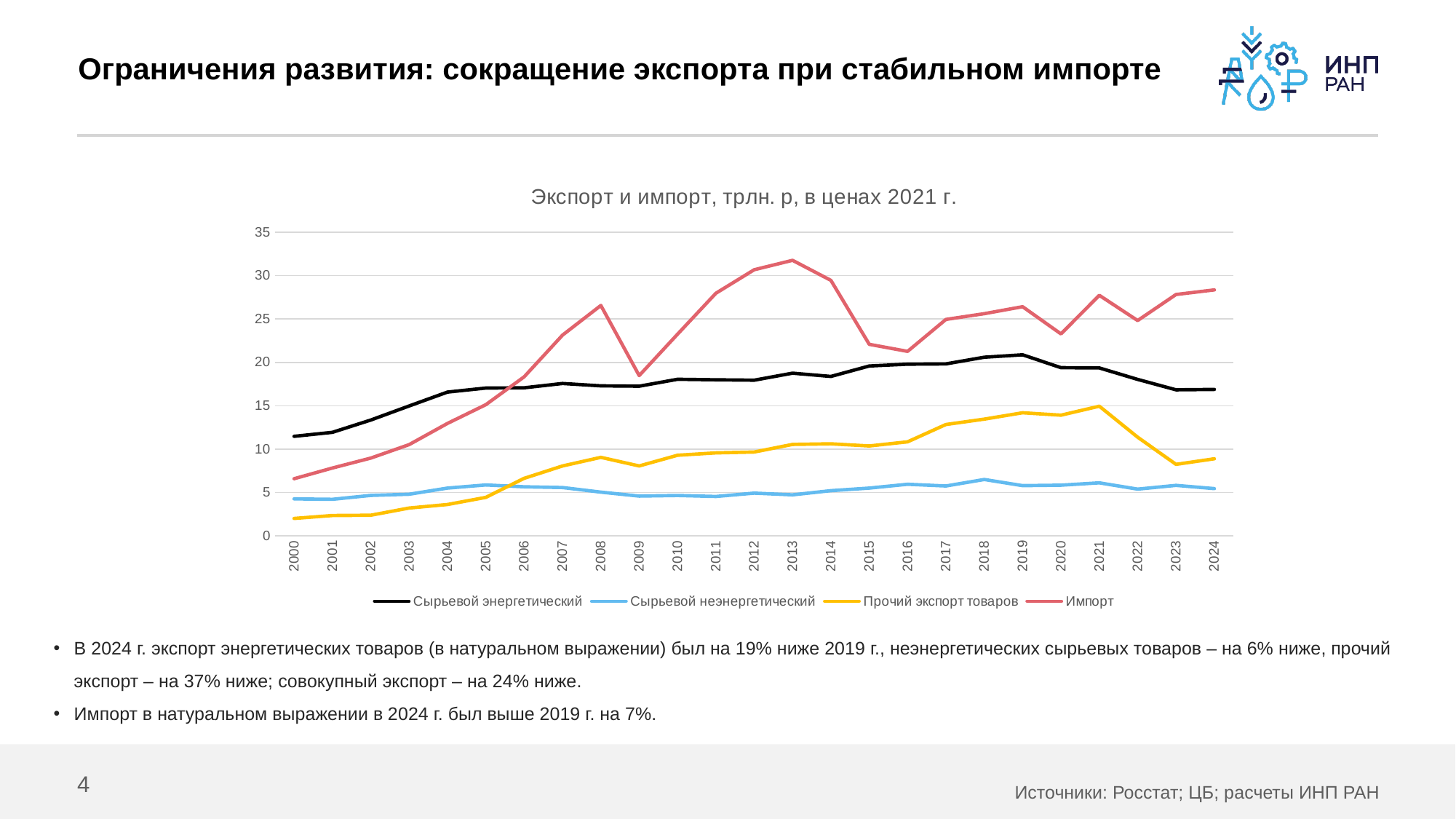
In which year does Импорт reach its highest value? 2013 Which series has the lowest value in 2000? Прочий экспорт товаров Is the value for Импорт in 2000 greater or less than 10? less Is the value for Импорт in 2013 greater or less than 30? greater How many series does the legend list? 4 Which series is drawn in red? Импорт Is the value for Сырьевой энергетический in 2024 greater or less than 15? greater How many years are plotted along the x axis? 25 What is the title of the chart? Экспорт и импорт, трлн. р, в ценах 2021 г. What kind of chart is shown on the slide? line chart Which series has the highest value in 2024? Импорт